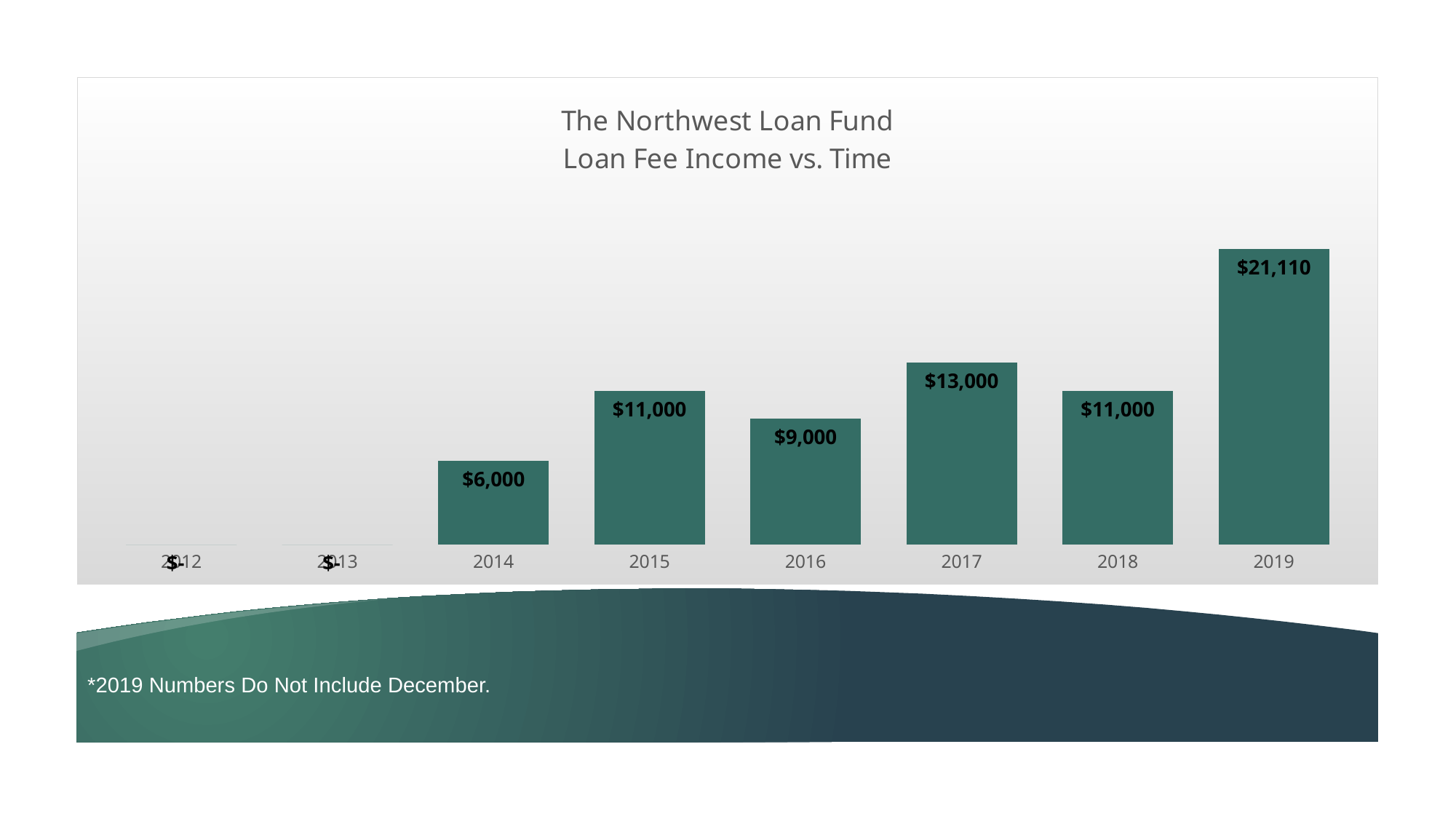
What is the loan fee income shown for 2014? $6,000 Does the loan fee income rise or fall from 2015 to 2016? Fall Which year has the highest loan fee income? 2019 What is the loan fee income shown for 2019? $21,110 Which year has the larger loan fee income, 2017 or 2018? 2017 What is the difference between the loan fee income in 2019 and in 2017? $8,110 What is the loan fee income shown for 2016? $9,000 What is the loan fee income shown for 2017? $13,000 What is the difference between the loan fee income in 2015 and in 2014? $5,000 Among the years with a bar shown, which year has the lowest loan fee income? 2014 What kind of chart is shown on the slide? Bar chart How many years are shown on the x axis? 8